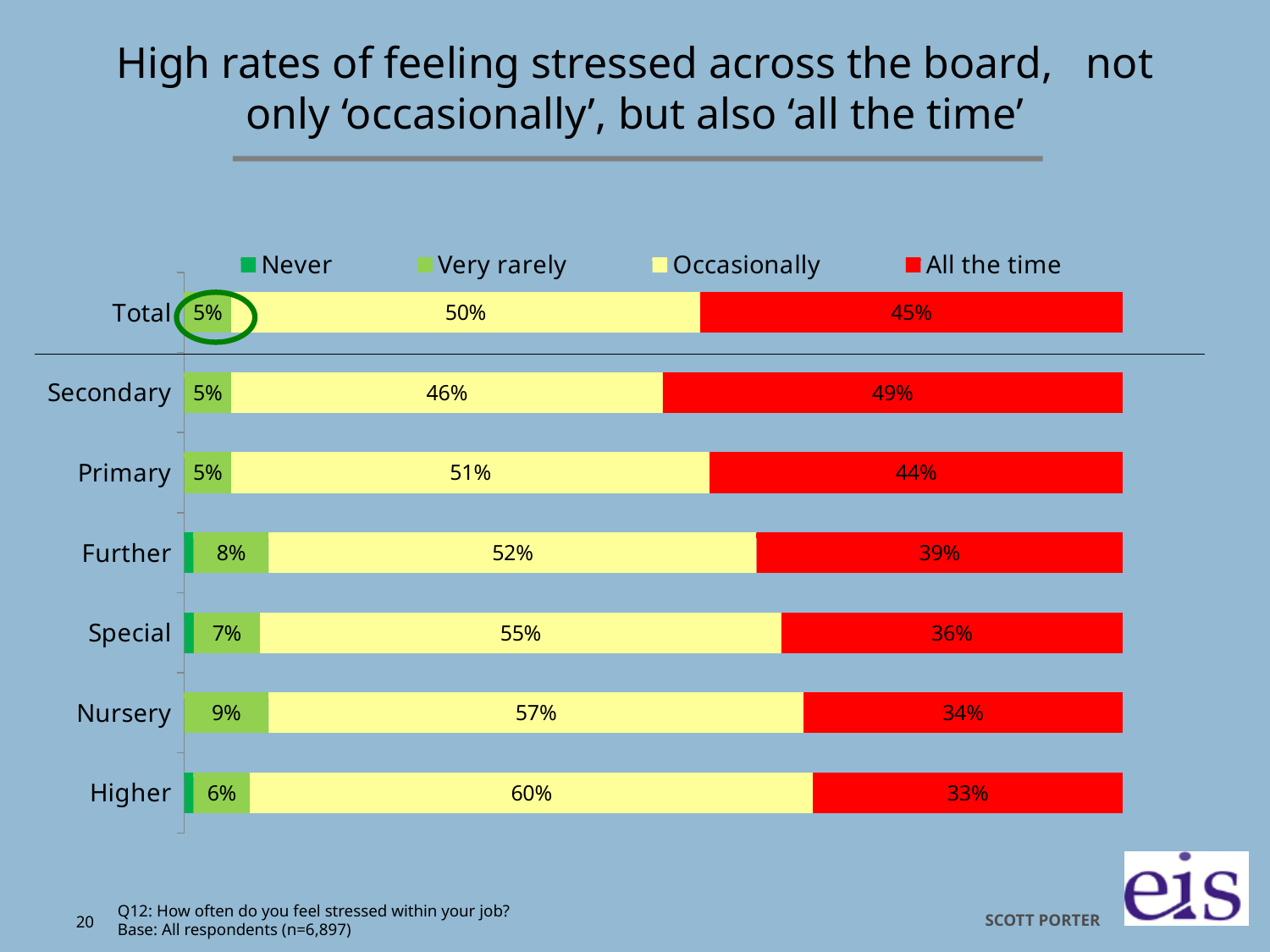
Which is larger, the 'Occasionally' value for Special or for Primary? Special What is the 'Very rarely' value for Nursery? 9% Which series is shown in red? All the time How many categories are shown on the chart? 7 What is the difference between the 'All the time' values for Secondary and Higher? 16% What is the 'All the time' value for Secondary? 49% What is the 'Occasionally' value for Higher? 60% Which category has the highest 'All the time' value? Secondary How many series does the legend list? 4 What kind of chart is shown on the slide? Stacked bar chart Which category has the lowest 'All the time' value? Higher Which category has the highest 'Occasionally' value? Higher